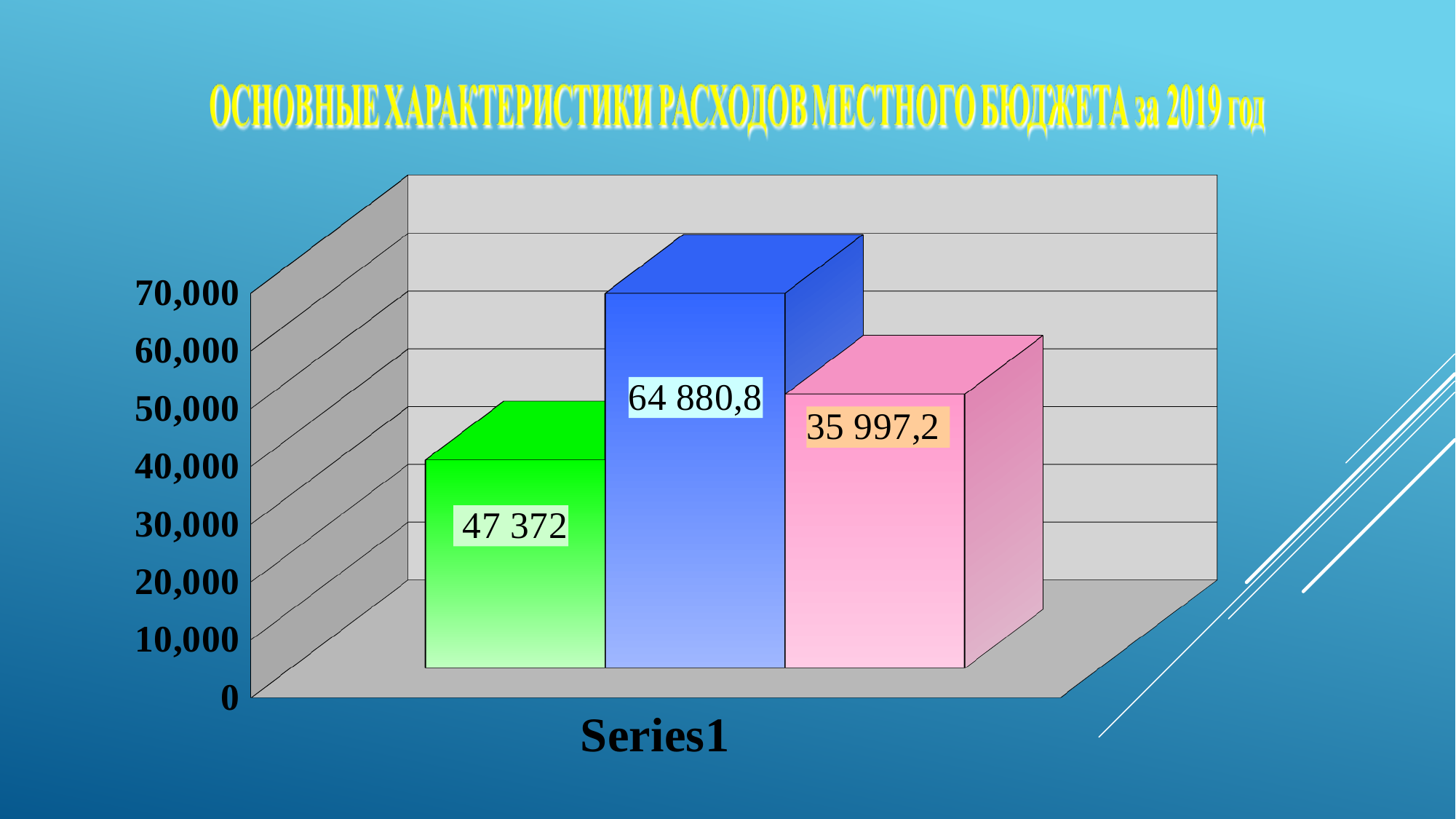
How many bars are plotted in the chart? 3 What type of chart is shown on the slide? Bar chart Is the value of the blue bar greater or less than 60,000? greater What is the difference between the green bar and the pink bar? 11 374,8 What value is shown on the green bar? 47 372 What is the title of the slide? ОСНОВНЫЕ ХАРАКТЕРИСТИКИ РАСХОДОВ МЕСТНОГО БЮДЖЕТА за 2019 год What is the difference between the blue bar and the green bar? 17 508,8 Which bar has the lowest value? The pink bar (35 997,2) Which bar has the highest value? The blue bar (64 880,8) What value is shown on the pink bar? 35 997,2 Which is larger, the green bar or the pink bar? The green bar What value is shown on the blue bar? 64 880,8